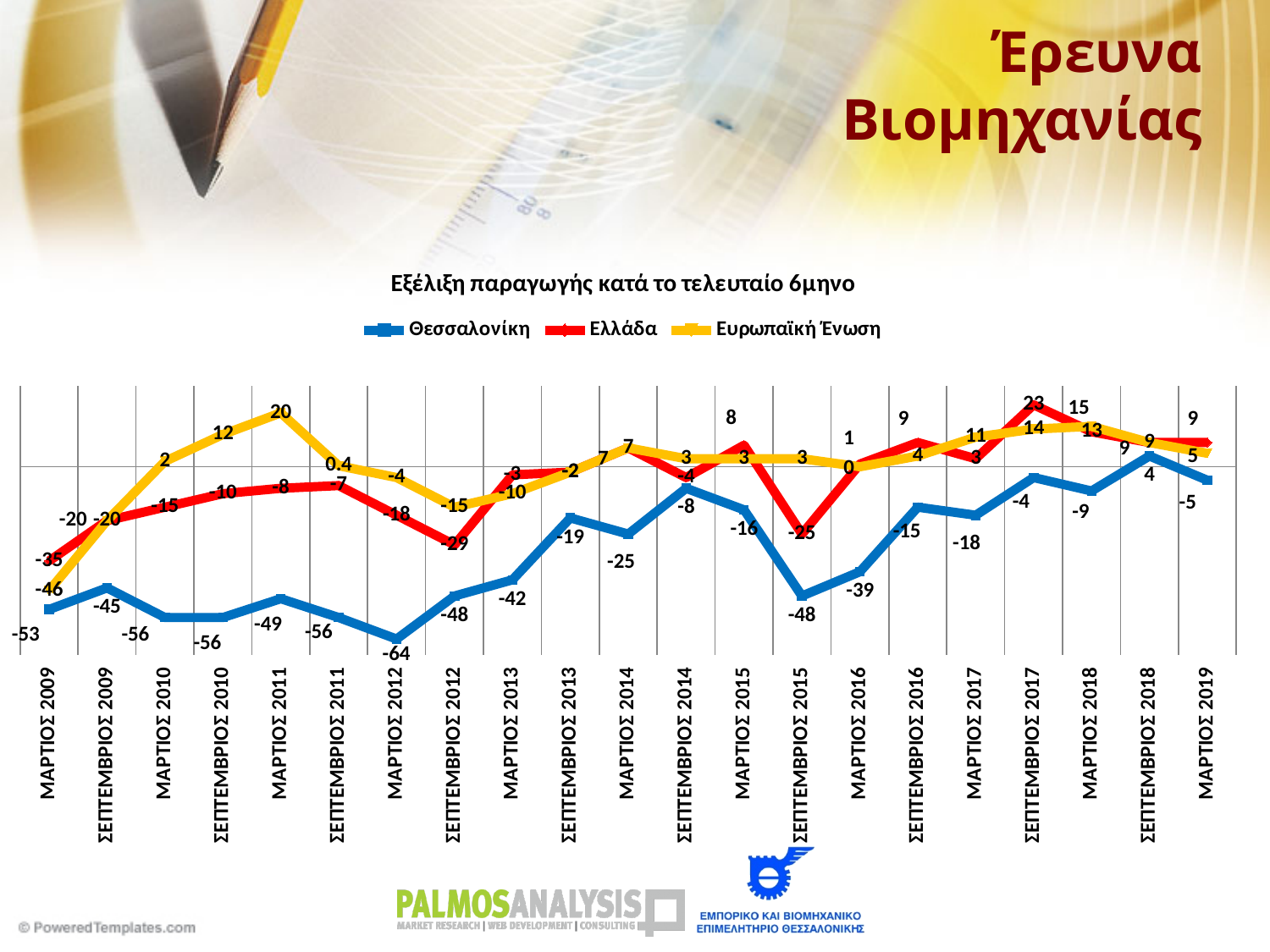
What is the title of the chart? Εξέλιξη παραγωγής κατά το τελευταίο 6μηνο What is the difference between the Θεσσαλονίκη values in ΜΑΡΤΙΟΣ 2016 (-39) and ΣΕΠΤΕΜΒΡΙΟΣ 2015 (-48)? 9 At which time point does the Θεσσαλονίκη series reach its highest value? ΣΕΠΤΕΜΒΡΙΟΣ 2018 Which series has the higher value in ΣΕΠΤΕΜΒΡΙΟΣ 2015, Ελλάδα or Θεσσαλονίκη? Ελλάδα What kind of chart is shown on the slide? line chart What is the value for Θεσσαλονίκη in ΜΑΡΤΙΟΣ 2012? -64 How many series does the legend list? 3 What is the value for Ευρωπαϊκή Ένωση in ΜΑΡΤΙΟΣ 2011? 20 At which time point does the Ελλάδα series reach its highest value? ΣΕΠΤΕΜΒΡΙΟΣ 2017 At which time point does the Θεσσαλονίκη series reach its lowest value? ΜΑΡΤΙΟΣ 2012 How many time points are plotted along the x axis? 21 What is the value for Θεσσαλονίκη in ΣΕΠΤΕΜΒΡΙΟΣ 2015? -48